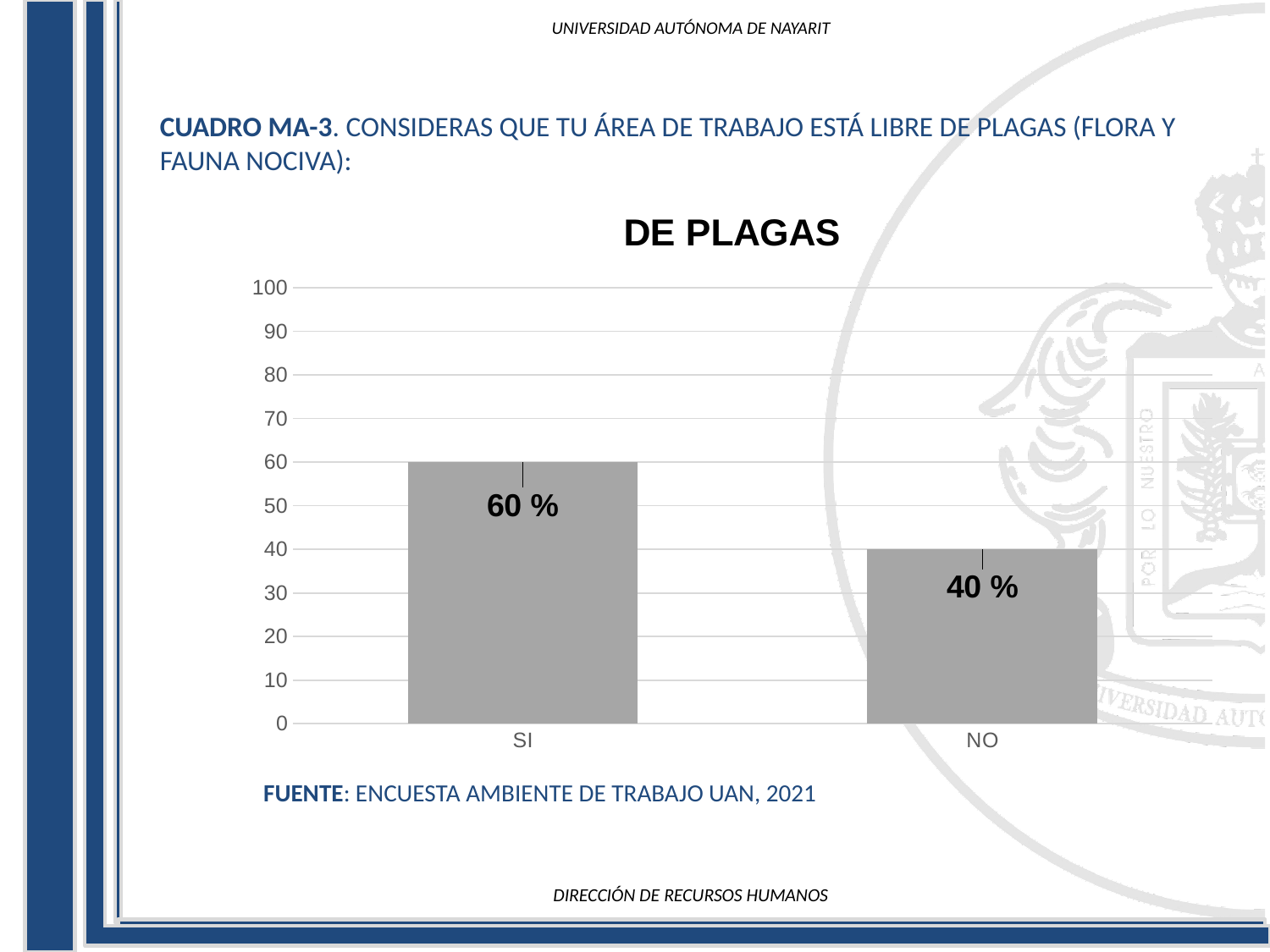
What is the value for SI? 60 % What kind of chart is shown on the slide? bar chart What is the difference between the values for SI and NO? 20 % Which is larger, the value for SI or the value for NO? SI What is the title of the chart? DE PLAGAS Is the value for SI greater or less than 50? greater What is the value for NO? 40 % Is the value for NO greater or less than 50? less Which category has the lowest value? NO Which category has the highest value? SI What is the highest value shown on the vertical axis? 100 How many categories are shown on the x axis? 2